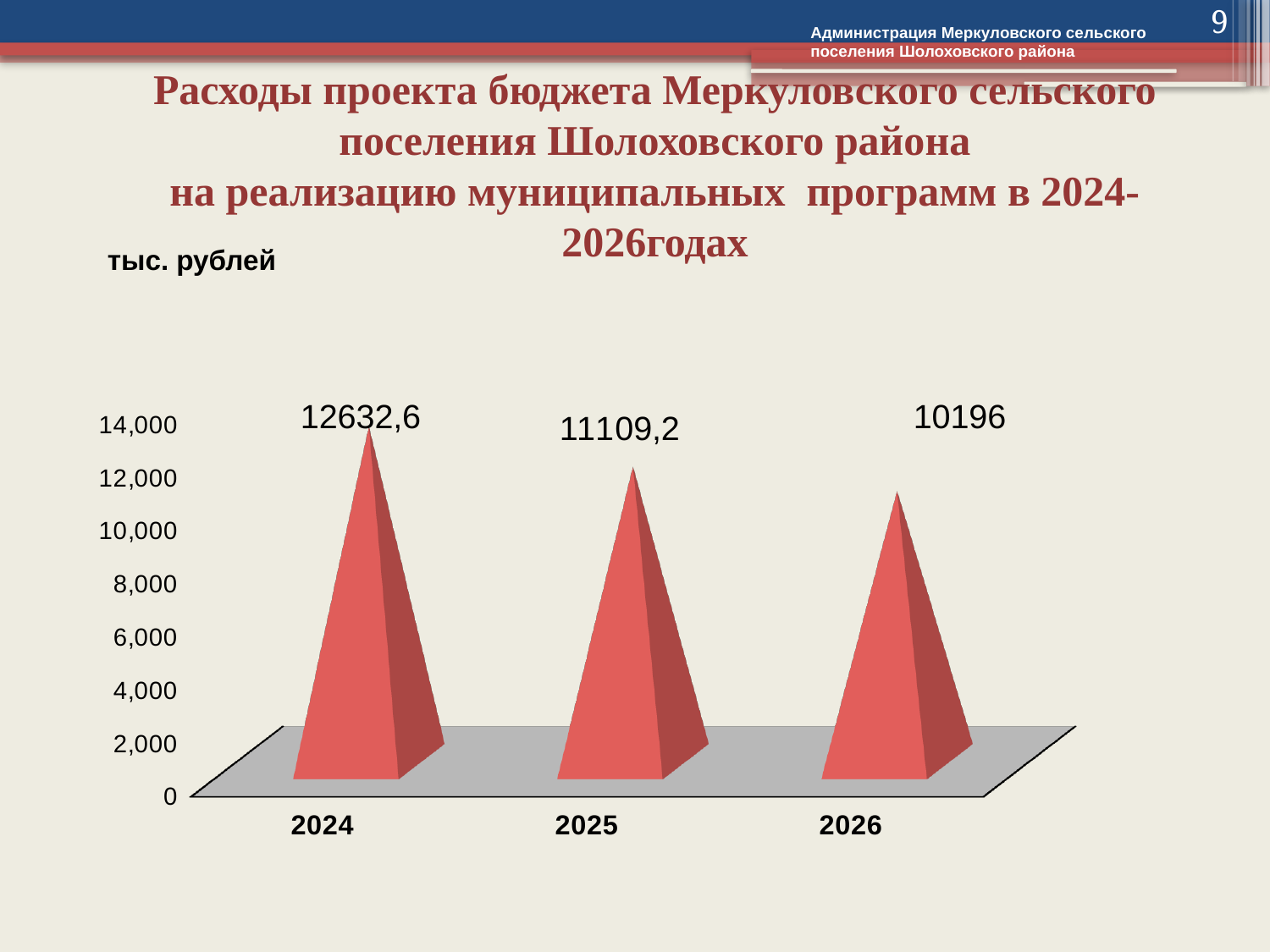
What is the difference between the values for 2024 and 2025? 1523,4 Which is larger, the value for 2025 or the value for 2026? 2025 How many years are shown on the chart? 3 Which year has the highest value? 2024 Is the value for 2026 greater or less than 12,000? less What is the value for 2024? 12632,6 What is the value for 2026? 10196 What is the difference between the values for 2025 and 2026? 913,2 What is the value for 2025? 11109,2 What kind of chart is shown on the slide? bar chart Which year has the lowest value? 2026 Do the values rise or fall from 2024 to 2026? fall